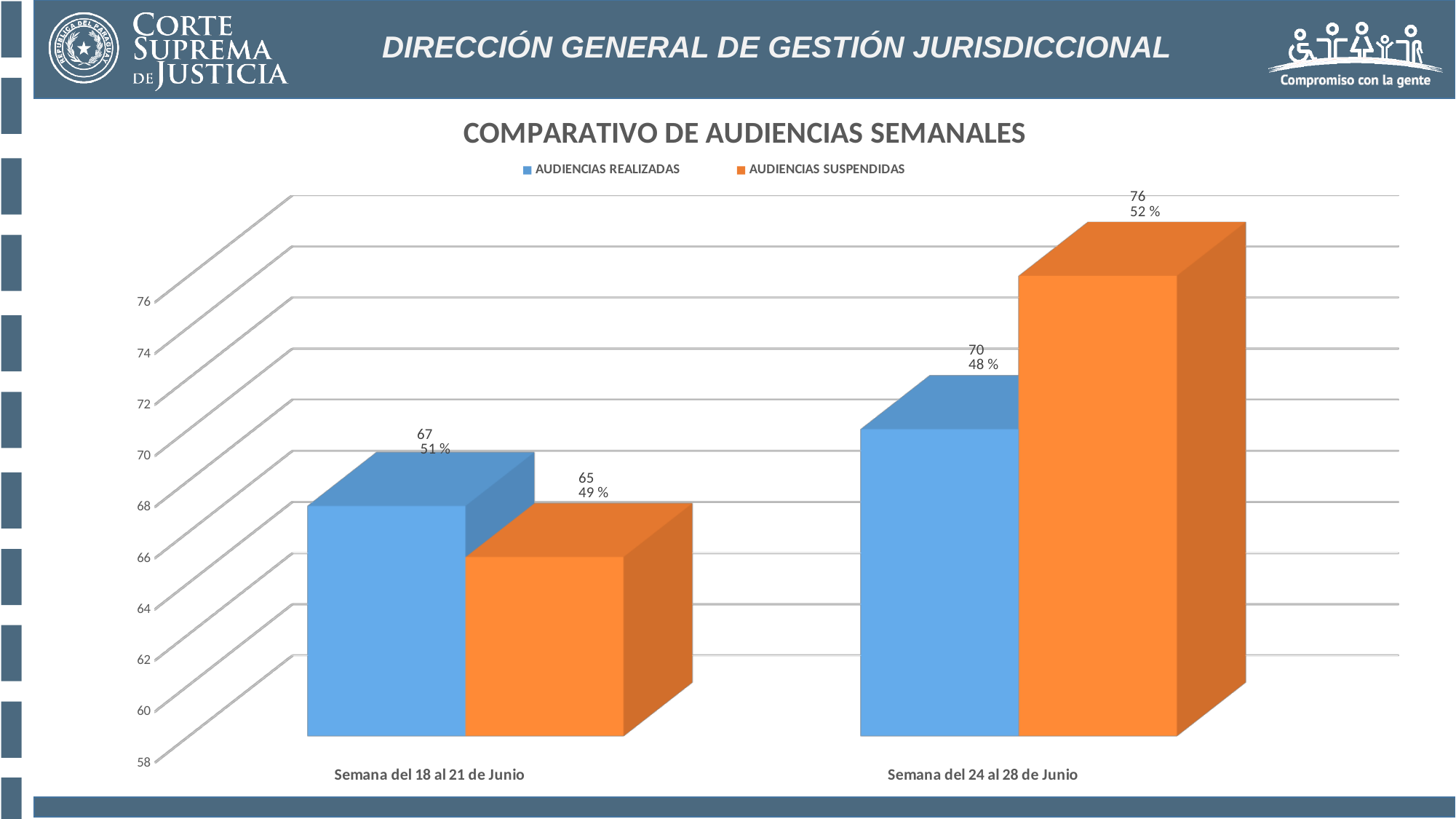
What percentage label is shown for AUDIENCIAS SUSPENDIDAS in Semana del 18 al 21 de Junio? 49 % Which week has the lowest value for AUDIENCIAS REALIZADAS? Semana del 18 al 21 de Junio How many weeks (categories) are shown on the x axis? 2 How many series does the legend list? 2 What is the value of AUDIENCIAS REALIZADAS for Semana del 18 al 21 de Junio? 67 Which week has the highest value for AUDIENCIAS SUSPENDIDAS? Semana del 24 al 28 de Junio What is the difference in AUDIENCIAS REALIZADAS between Semana del 24 al 28 de Junio and Semana del 18 al 21 de Junio? 3 What is the value of AUDIENCIAS SUSPENDIDAS for Semana del 24 al 28 de Junio? 76 What type of chart is shown on the slide? Bar chart What is the difference between AUDIENCIAS SUSPENDIDAS and AUDIENCIAS REALIZADAS for Semana del 24 al 28 de Junio? 6 For Semana del 18 al 21 de Junio, which is larger: AUDIENCIAS REALIZADAS or AUDIENCIAS SUSPENDIDAS? AUDIENCIAS REALIZADAS What is the value of AUDIENCIAS REALIZADAS for Semana del 24 al 28 de Junio? 70